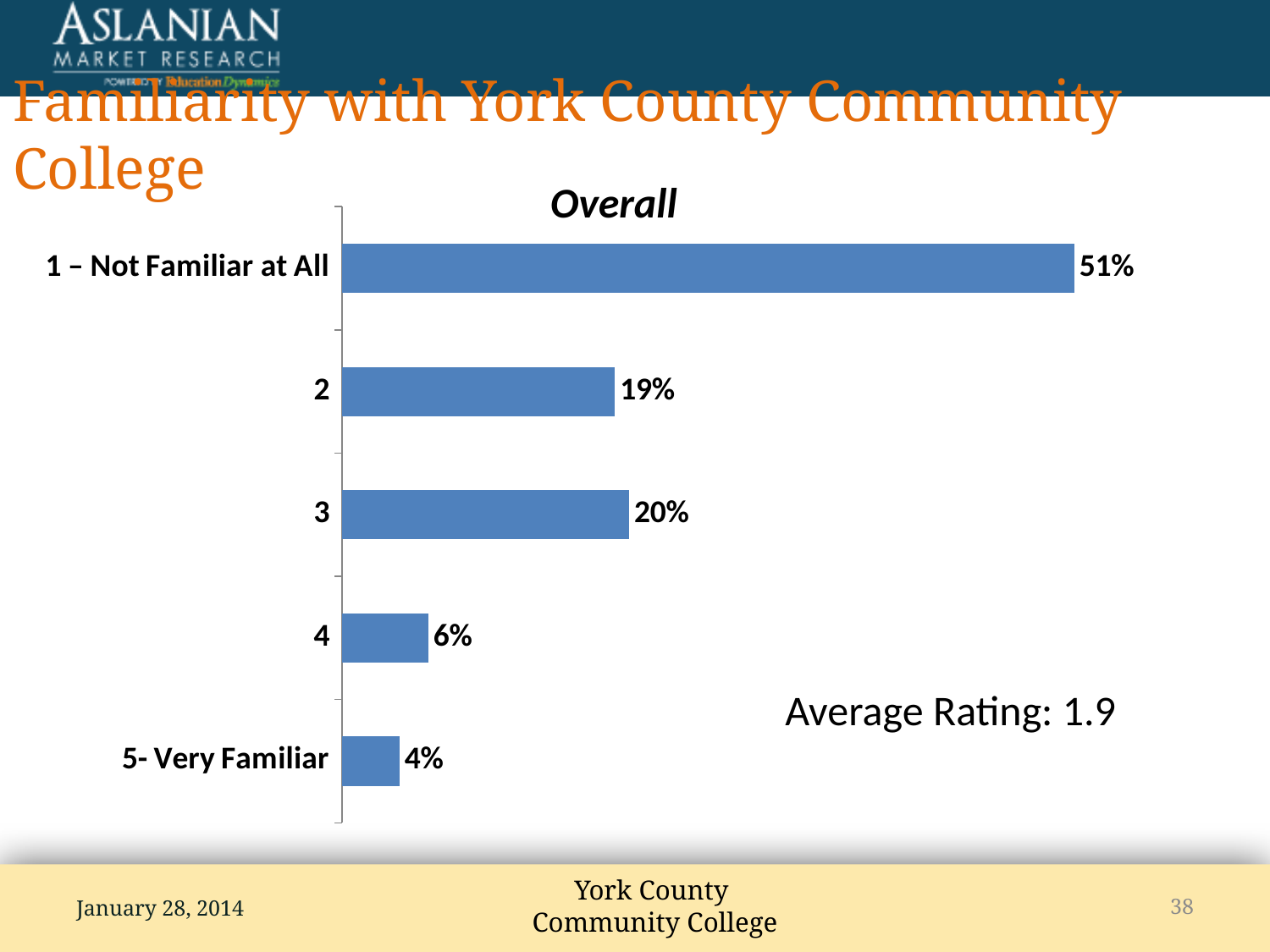
Which is larger, the value for rating '2' or rating '3'? 3 What is the title of the chart? Overall What is the value for rating '4'? 6% How many categories are shown in the chart? 5 What percentage of respondents rated their familiarity as '1 - Not Familiar at All'? 51% What is the value for rating '3'? 20% What average rating is stated on the slide? 1.9 Which category has the highest value? 1 - Not Familiar at All Which category has the lowest value? 5- Very Familiar What type of chart is shown on the slide? Bar chart What percentage of respondents chose '5- Very Familiar'? 4% What is the difference between the values for '1 - Not Familiar at All' and '2'? 32%